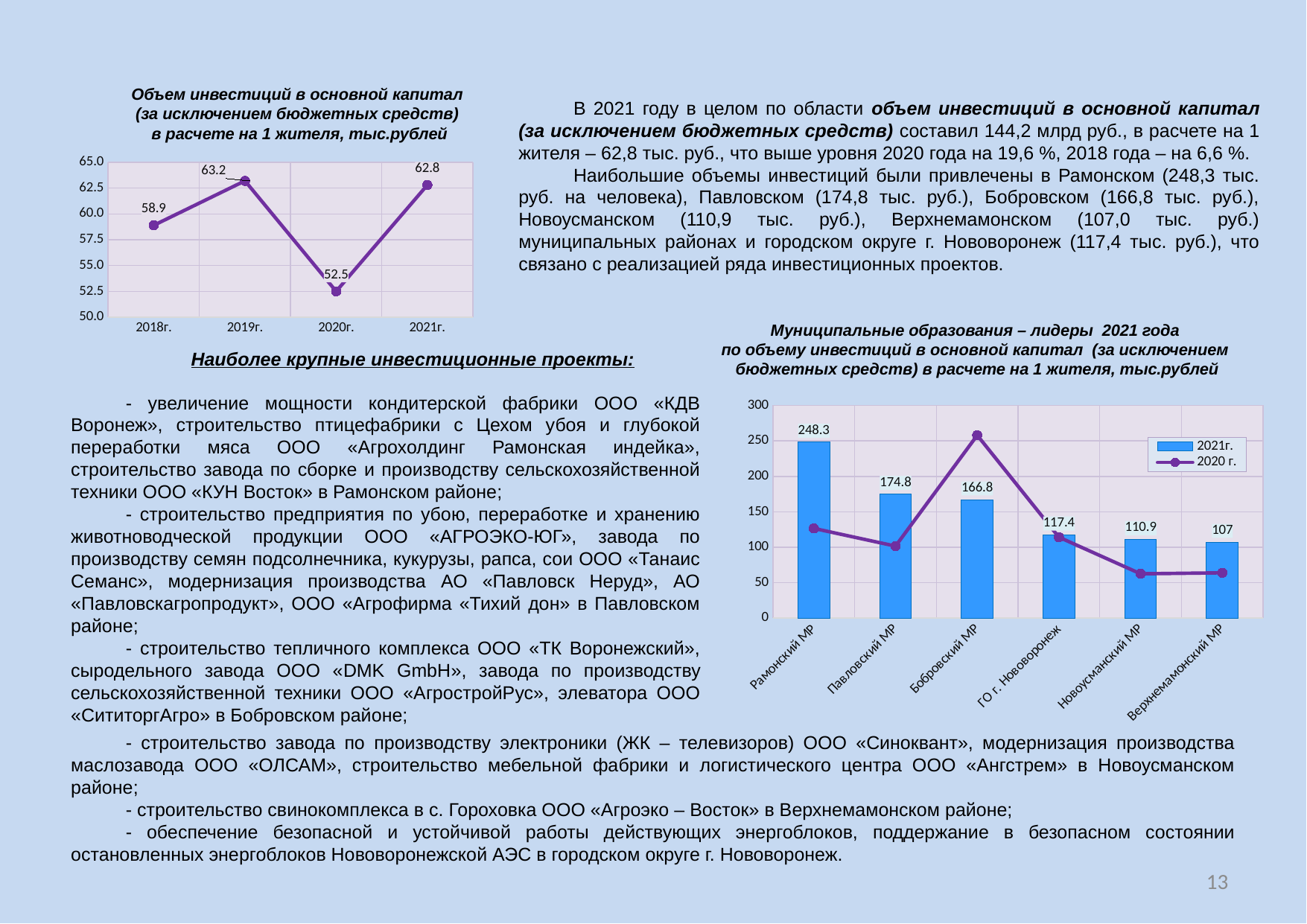
In the right chart 'Муниципальные образования – лидеры 2021 года', which municipality has the lowest 2021г. value? Верхнемамонский МР In the right chart 'Муниципальные образования – лидеры 2021 года', what is the 2021г. value for ГО г. Нововоронеж? 117.4 In the right chart 'Муниципальные образования – лидеры 2021 года', what is the 2021г. value for Рамонский МР? 248.3 In the left chart 'Объем инвестиций в основной капитал (за исключением бюджетных средств) в расчете на 1 жителя', what is the value for 2019г.? 63.2 In the right chart 'Муниципальные образования – лидеры 2021 года', is the 2020 г. value for Бобровский МР greater or less than 250? greater What type of chart is the left chart 'Объем инвестиций в основной капитал'? Line chart In the left chart 'Объем инвестиций в основной капитал', how many years are plotted? 4 In the left chart 'Объем инвестиций в основной капитал', what is the difference between the 2021г. and 2020г. values? 10.3 In the left chart 'Объем инвестиций в основной капитал', which year has the highest value? 2019г. In the left chart 'Объем инвестиций в основной капитал', which year has the lowest value? 2020г. In the left chart 'Объем инвестиций в основной капитал', what is the value for 2020г.? 52.5 In the right chart 'Муниципальные образования – лидеры 2021 года', how many series does the legend list? 2